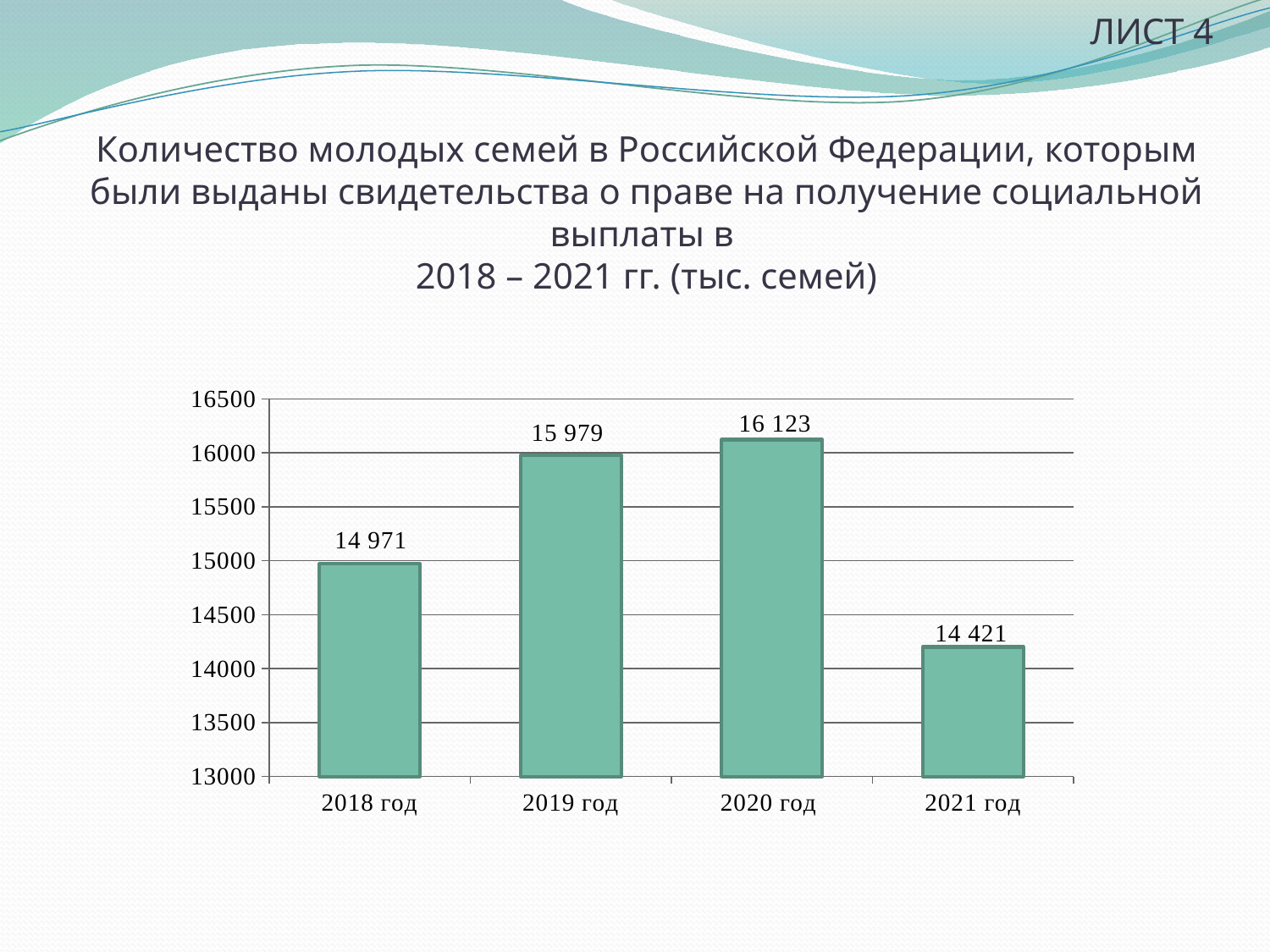
Which is larger, the value for 2018 год or the value for 2021 год? 2018 год How many years are shown on the chart? 4 What is the difference between the values for 2020 год and 2021 год? 1 702 What is the difference between the values for 2019 год and 2018 год? 1 008 What is the value for 2020 год? 16 123 What kind of chart is shown on the slide? bar chart What is the value for 2019 год? 15 979 What is the value for 2018 год? 14 971 Which year has the lowest value? 2021 год Which year has the highest value? 2020 год What is the value for 2021 год? 14 421 Is the value for 2019 год greater or less than 16000? less